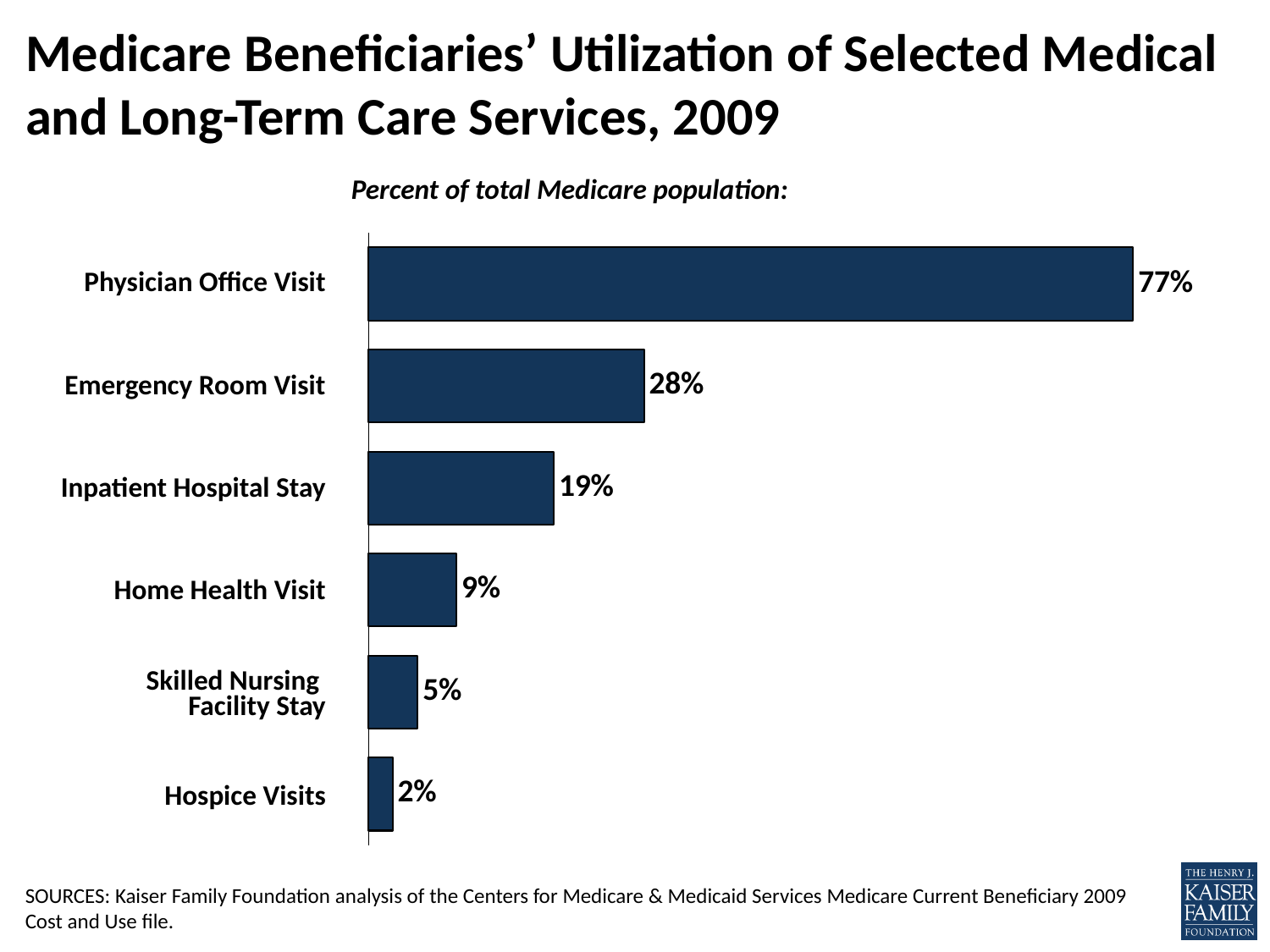
What is the subtitle shown above the chart? Percent of total Medicare population: What is the value shown for Emergency Room Visit? 28% Which is larger, Home Health Visit or Skilled Nursing Facility Stay? Home Health Visit What is the difference between the Emergency Room Visit and Inpatient Hospital Stay percentages? 9% What percent of the Medicare population had an Inpatient Hospital Stay? 19% What is the value shown for Skilled Nursing Facility Stay? 5% How many services are shown in the chart? 6 What kind of chart is shown on the slide? Bar chart Which service has the highest utilization? Physician Office Visit What percent of the Medicare population had a Physician Office Visit? 77% Which service has the lowest utilization? Hospice Visits What is the difference between the Physician Office Visit and Home Health Visit percentages? 68%